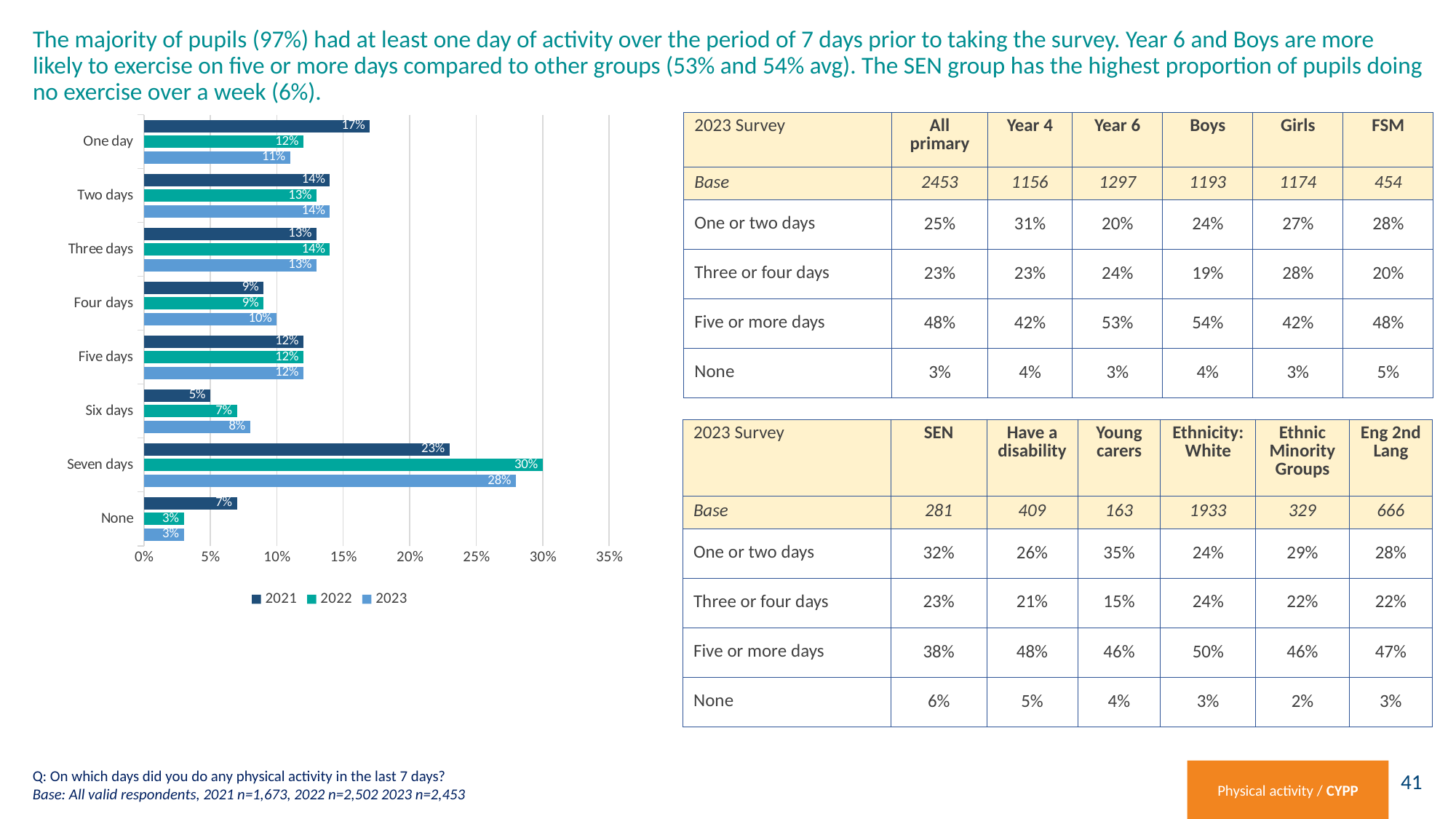
Is the 2022 value for Seven days greater or less than 25%? greater What kind of chart is shown on the left of the slide? bar chart What is the difference between the 2022 and 2021 values for Seven days? 7% Which series is shown in the darkest blue colour in the legend? 2021 What is the 2023 value for Seven days? 28% Which is larger for None: the 2021 value or the 2023 value? 2021 What is the 2021 value for One day? 17% How many categories are shown on the chart's vertical axis? 8 What is the 2022 value for Six days? 7% How many series does the chart legend list? 3 Which category has the highest 2022 value? Seven days Which category has the lowest 2021 value? Six days